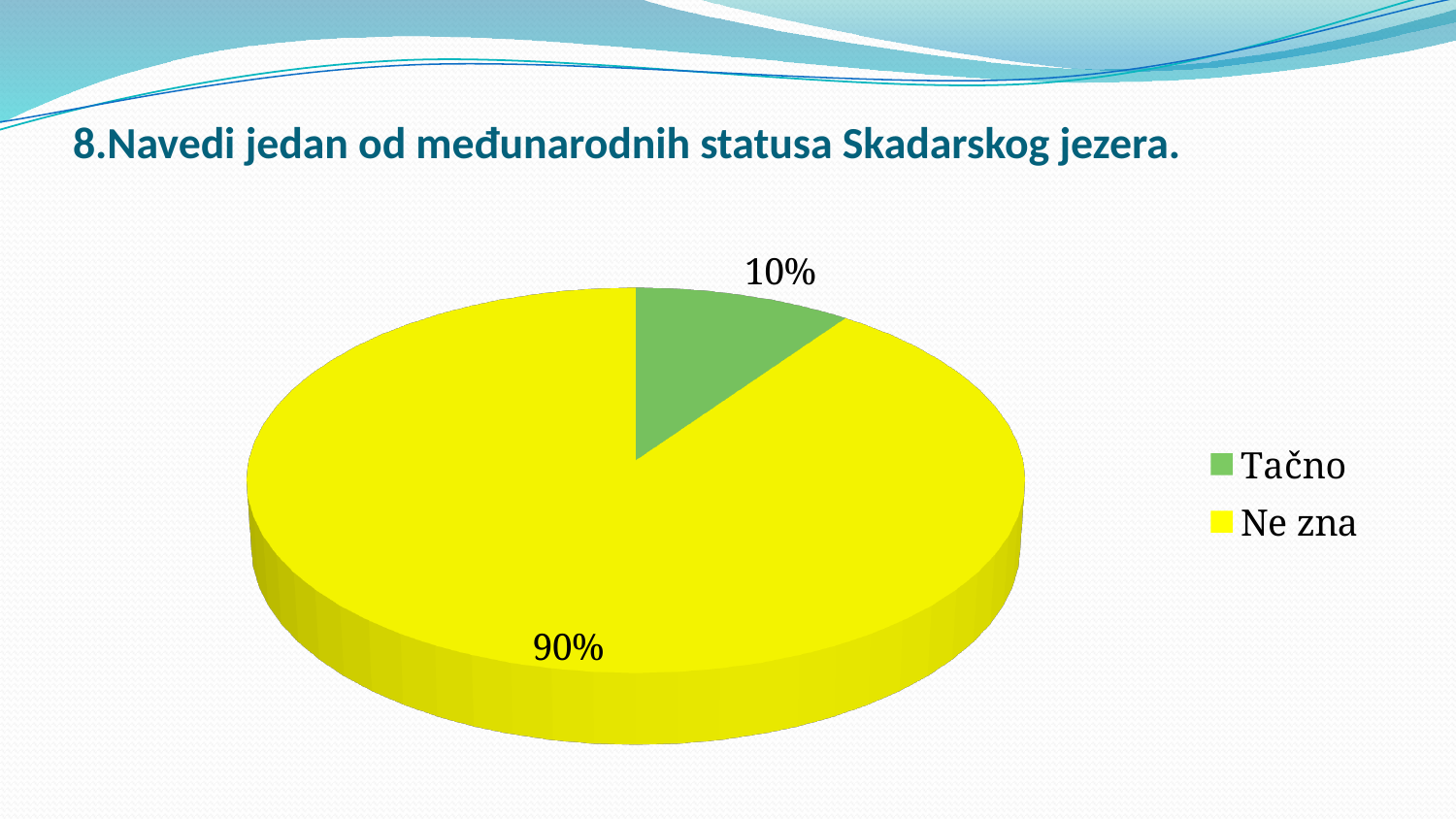
What kind of chart is shown on the slide? Pie chart How many entries does the legend list? 2 How many slices does the pie chart have? 2 What colour is the "Ne zna" slice in the pie chart? Yellow What is the difference in percentage points between the "Ne zna" slice and the "Tačno" slice? 80 What share of the pie does the "Tačno" slice represent? 10% Which slice is larger, "Tačno" or "Ne zna"? Ne zna Which category has the largest slice of the pie chart? Ne zna Which category has the smallest slice of the pie chart? Tačno What colour is the "Tačno" slice in the pie chart? Green What percentage of the pie chart is labelled "Tačno"? 10% What percentage of the pie chart is labelled "Ne zna"? 90%